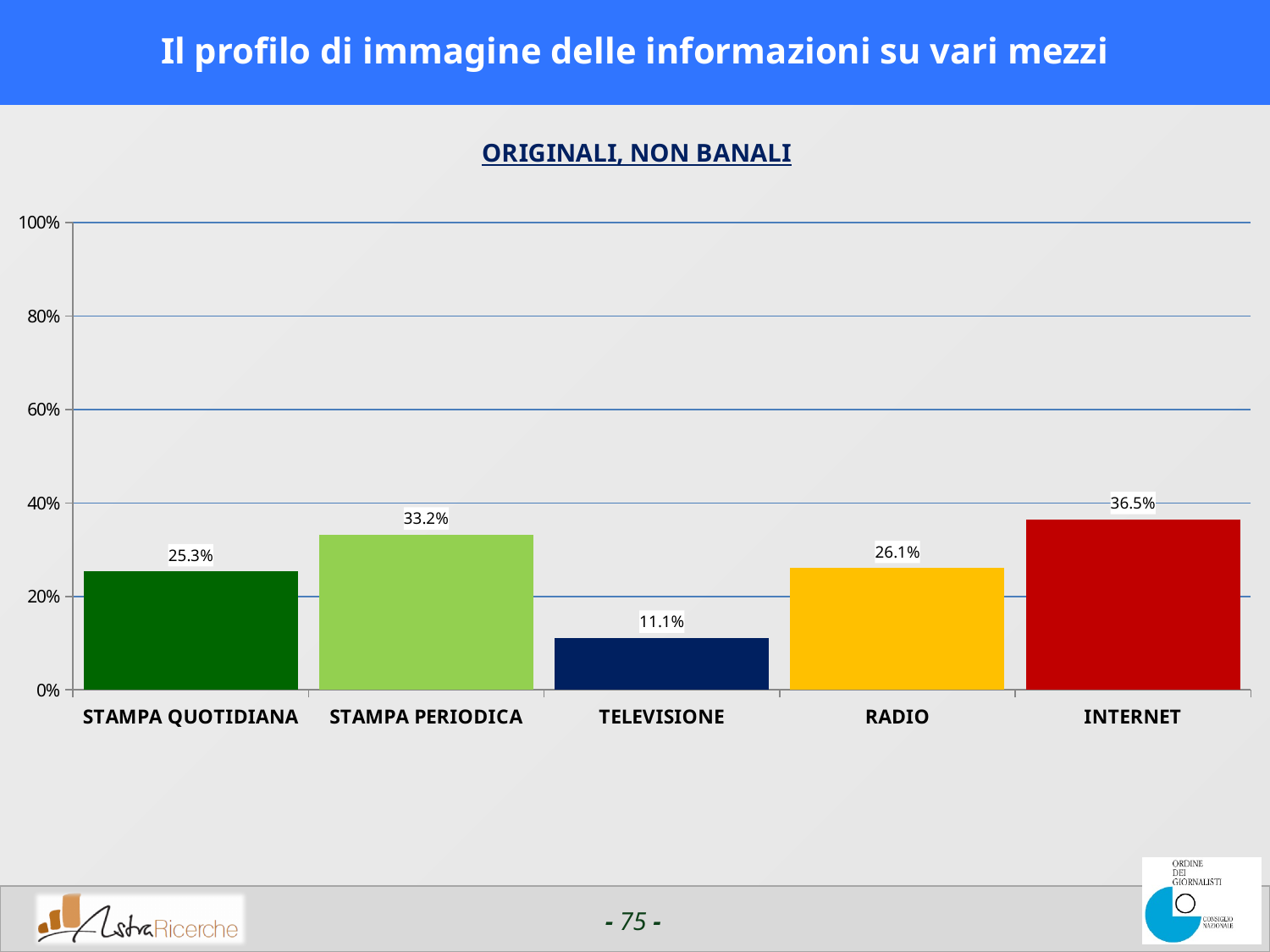
Which is larger, the value for STAMPA QUOTIDIANA or the value for STAMPA PERIODICA? STAMPA PERIODICA What is the value for STAMPA PERIODICA? 33.2% What is the difference between the values for INTERNET and TELEVISIONE? 25.4% What is the value for RADIO? 26.1% What is the value for TELEVISIONE? 11.1% What is the title of the chart? ORIGINALI, NON BANALI What kind of chart is shown on the slide? bar chart What is the value for INTERNET? 36.5% Is the value for RADIO greater or less than 20%? greater How many categories are shown on the x axis? 5 Which category has the highest value? INTERNET Which category has the lowest value? TELEVISIONE